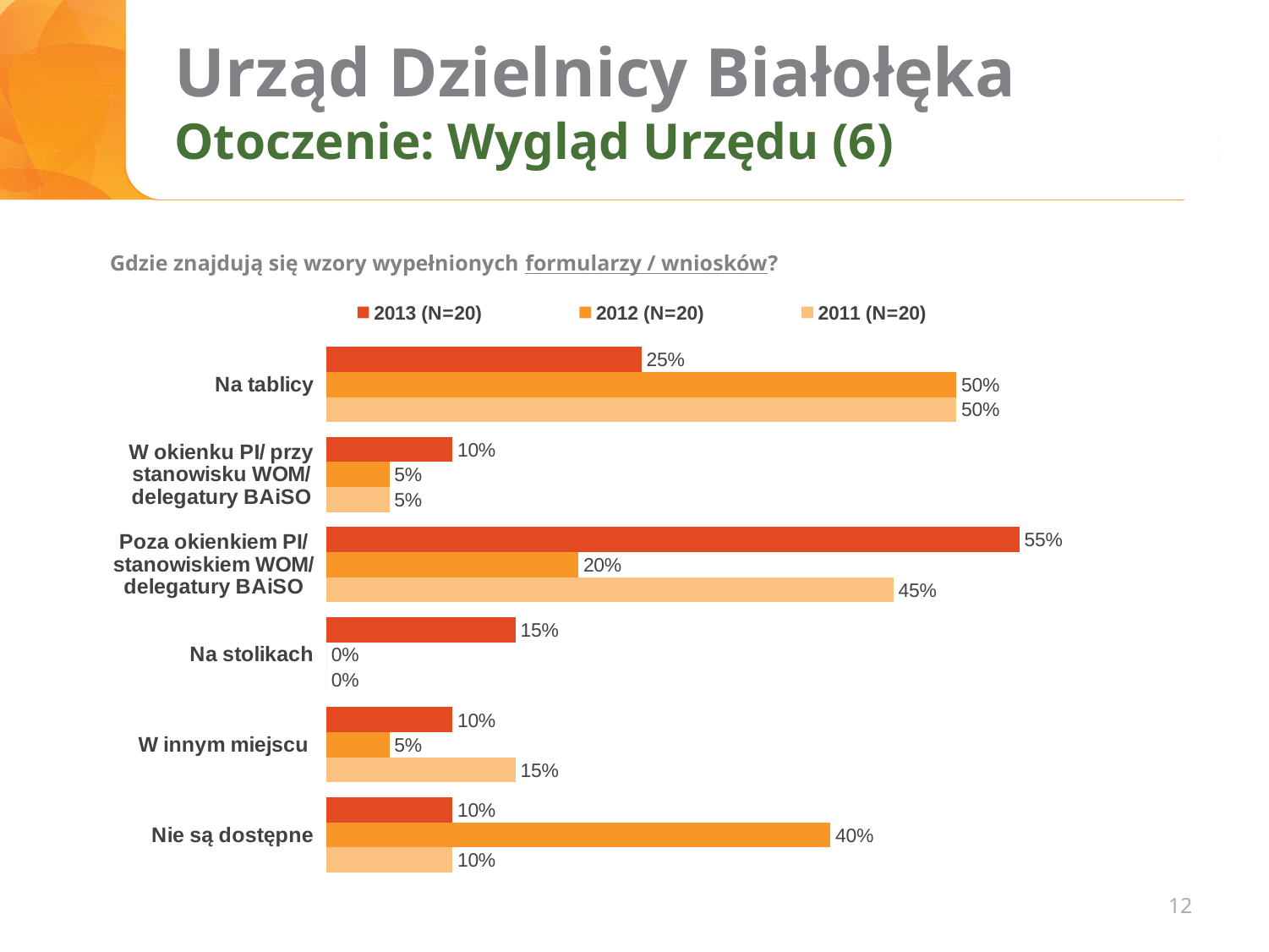
What question is the chart answering, as stated above it? Gdzie znajdują się wzory wypełnionych formularzy / wniosków? Which category has the lowest value in the 2012 (N=20) series? Na stolikach What is the value for "Na tablicy" in the 2013 (N=20) series? 25% What is the value for "Poza okienkiem PI/ stanowiskiem WOM/ delegatury BAiSO" in the 2011 (N=20) series? 45% How many categories are shown on the chart? 6 How many series does the legend list? 3 Which is larger for "Nie są dostępne": the 2012 (N=20) value or the 2011 (N=20) value? 2012 (N=20) Which category has the highest value in the 2013 (N=20) series? Poza okienkiem PI/ stanowiskiem WOM/ delegatury BAiSO What is the value for "Nie są dostępne" in the 2012 (N=20) series? 40% What is the difference between the 2012 (N=20) and 2013 (N=20) values for "Na tablicy"? 25% What is the difference between the 2013 (N=20) and 2012 (N=20) values for "Poza okienkiem PI/ stanowiskiem WOM/ delegatury BAiSO"? 35% What kind of chart is shown on the slide? Bar chart